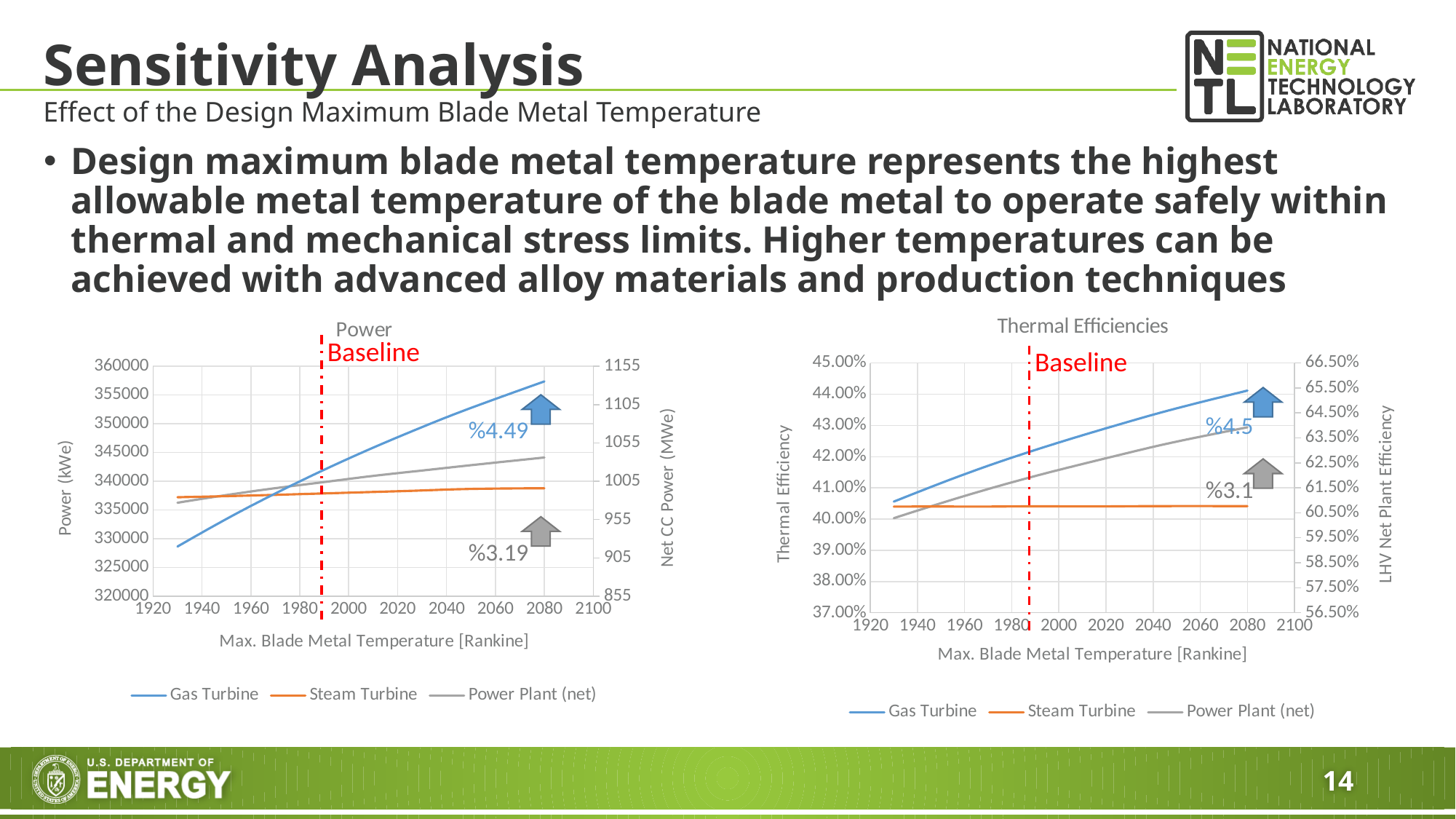
How many series does the legend of the Thermal Efficiencies chart list? 3 In the Power chart, is the Gas Turbine value at 1930 Rankine greater or less than 330000? less In the Thermal Efficiencies chart, is the Steam Turbine value at 2080 Rankine greater or less than 41.00%? less What kind of chart is the Power chart on the left? line chart In the Power chart, which line is higher at 2080 Rankine: Gas Turbine or Steam Turbine? Gas Turbine In the Power chart, what percentage is annotated next to the blue arrow for the Gas Turbine line? %4.49 In the Power chart, does the Gas Turbine line rise or fall as Max. Blade Metal Temperature increases? rise In the Thermal Efficiencies chart, is the Gas Turbine value at 2080 Rankine greater or less than 43.00%? greater What is the x-axis label of the Thermal Efficiencies chart? Max. Blade Metal Temperature [Rankine] In the Thermal Efficiencies chart, does the Power Plant (net) line rise or fall as Max. Blade Metal Temperature increases? rise In the Power chart, which line is higher at 1930 Rankine: Gas Turbine or Steam Turbine? Steam Turbine